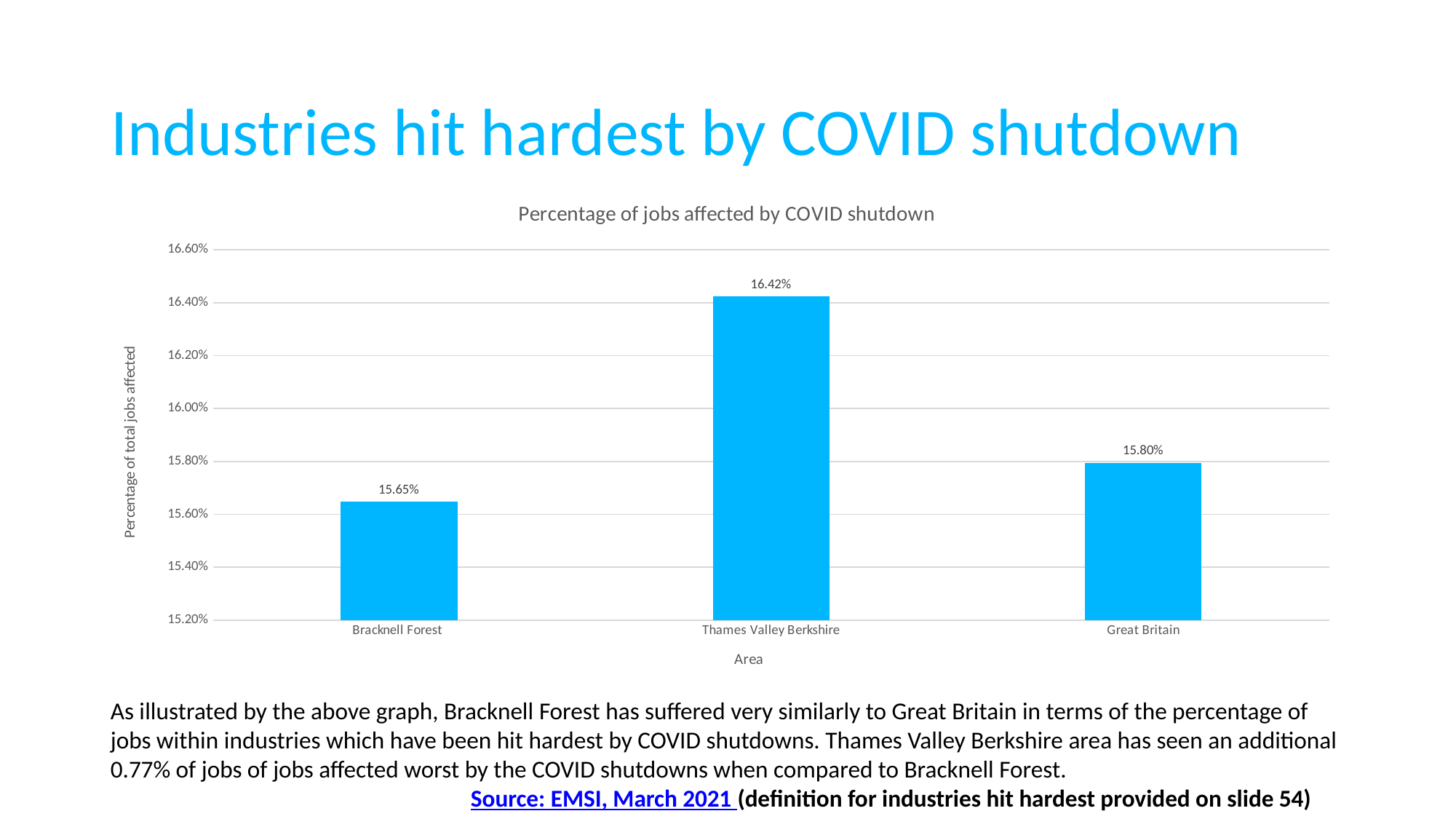
Which area has the lowest percentage of jobs affected by COVID shutdown? Bracknell Forest What is the title of the chart? Percentage of jobs affected by COVID shutdown What is the percentage of jobs affected by COVID shutdown for Bracknell Forest? 15.65% What type of chart is shown on the slide? Bar chart What is the percentage of jobs affected by COVID shutdown for Great Britain? 15.80% How many areas are shown in the chart? 3 Which area has the highest percentage of jobs affected by COVID shutdown? Thames Valley Berkshire Which has a higher percentage of jobs affected, Great Britain or Bracknell Forest? Great Britain What is the difference in percentage points between Thames Valley Berkshire and Bracknell Forest? 0.77% What is the percentage of jobs affected by COVID shutdown for Thames Valley Berkshire? 16.42% What is the difference in percentage points between Great Britain and Bracknell Forest? 0.15% Is the value for Thames Valley Berkshire greater or less than 16.00%? greater